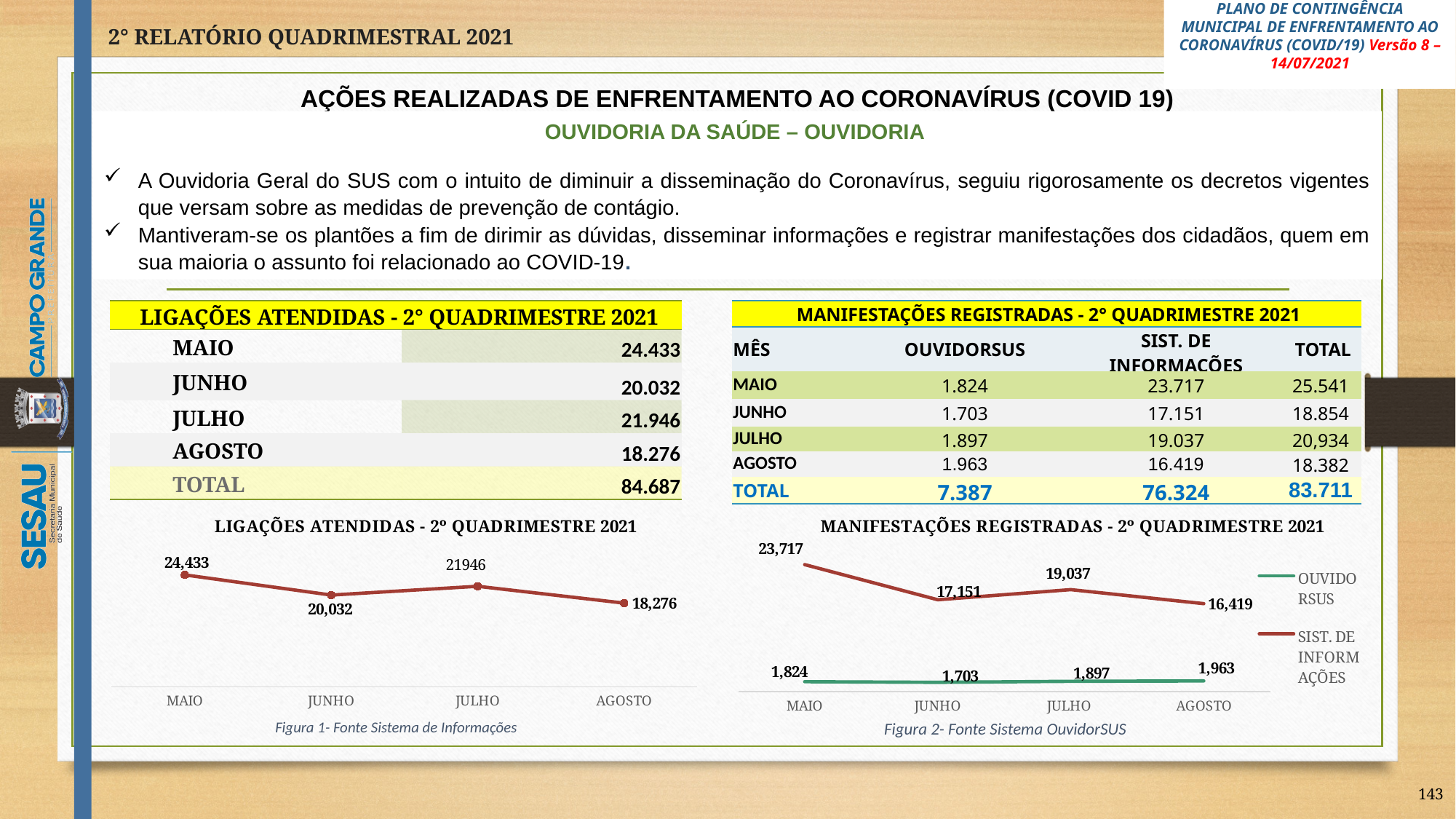
In the MANIFESTAÇÕES REGISTRADAS chart, is the SIST. DE INFORMAÇÕES value for JUNHO larger or smaller than for JULHO? Smaller In the MANIFESTAÇÕES REGISTRADAS chart, what is the SIST. DE INFORMAÇÕES value for MAIO? 23,717 What type of chart is the LIGAÇÕES ATENDIDAS chart? Line chart In the LIGAÇÕES ATENDIDAS chart, which month has the lowest value? AGOSTO In the MANIFESTAÇÕES REGISTRADAS chart, what is the difference between the SIST. DE INFORMAÇÕES values for MAIO and AGOSTO? 7,298 In the LIGAÇÕES ATENDIDAS chart, what is the difference between MAIO and JUNHO? 4,401 In the MANIFESTAÇÕES REGISTRADAS chart, how many series does the legend list? 2 In the MANIFESTAÇÕES REGISTRADAS chart, which month has the highest OUVIDORSUS value? AGOSTO In the LIGAÇÕES ATENDIDAS chart, what is the value for MAIO? 24,433 In the LIGAÇÕES ATENDIDAS chart, how many months are plotted? 4 In the MANIFESTAÇÕES REGISTRADAS chart, what is the OUVIDORSUS value for JULHO? 1,897 In the LIGAÇÕES ATENDIDAS chart, what is the value for AGOSTO? 18,276